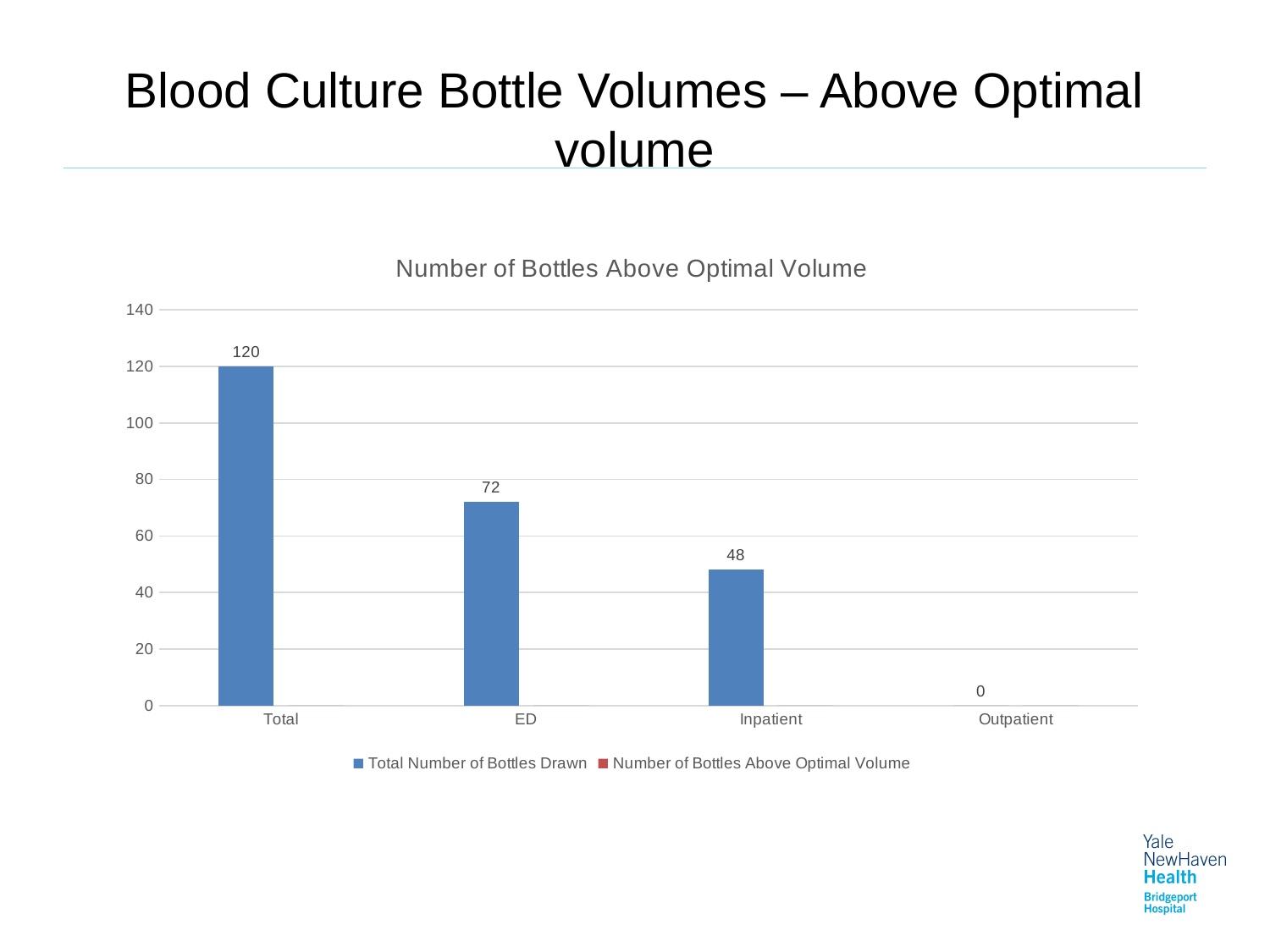
What is the value for ED in the chart? 72 What is the title of the chart? Number of Bottles Above Optimal Volume Which is larger, the value for ED or the value for Inpatient? ED Is the value for Inpatient greater or less than 60? less What kind of chart is shown on the slide? bar chart Which category has the lowest value in the chart? Outpatient Which category has the highest value in the chart? Total What is the difference between the values for ED and Inpatient? 24 What is the value for Inpatient in the chart? 48 How many series does the legend list? 2 What is the value for Outpatient in the chart? 0 How many categories are shown on the x axis of the chart? 4